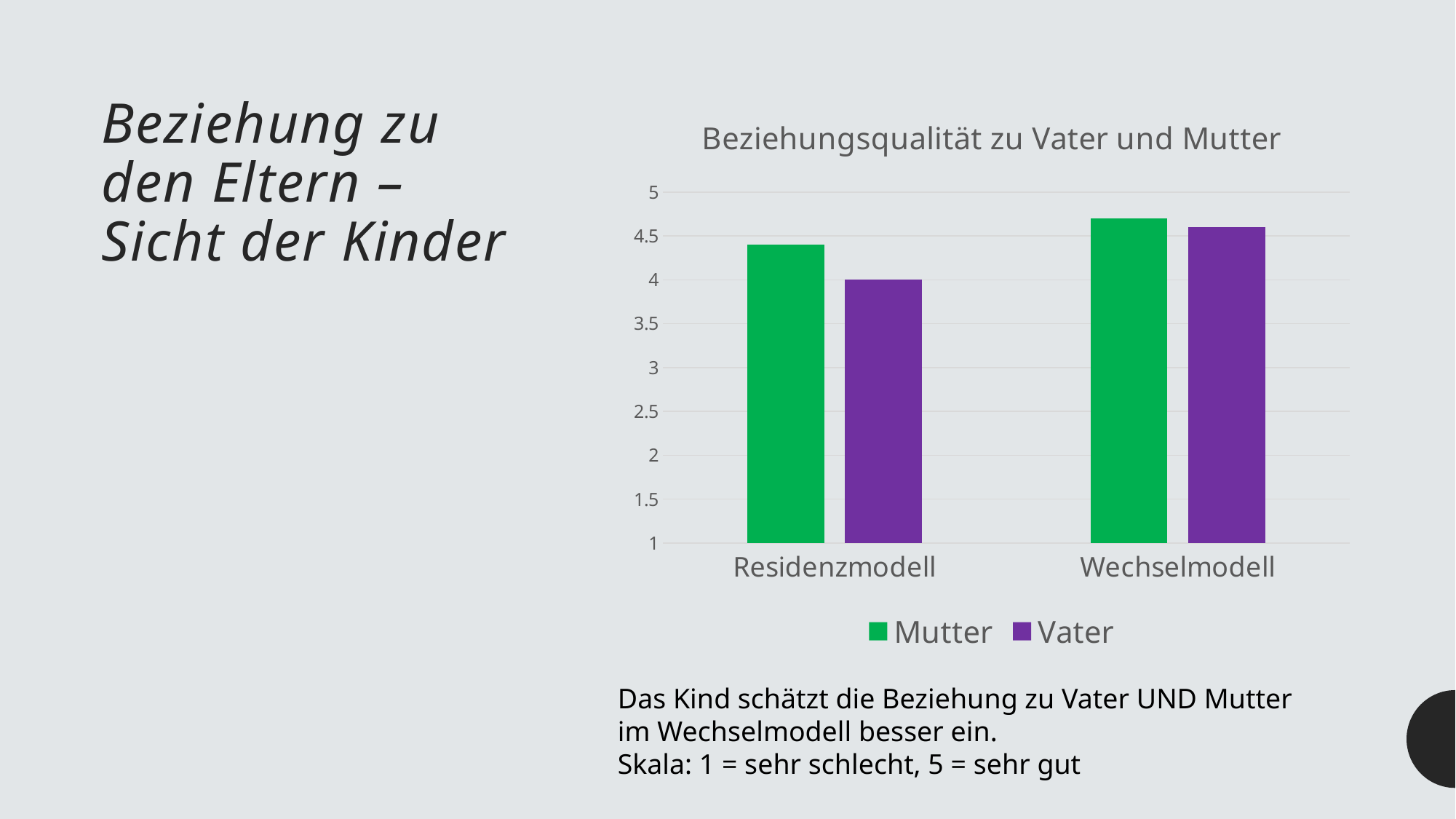
Is the value for Mutter in the Residenzmodell category greater or less than 4? greater Which bar is the lowest in the chart? Vater, Residenzmodell How many categories are shown on the x axis? 2 Is the value for Mutter in the Wechselmodell category greater or less than 4.5? greater Is the value for Vater in the Wechselmodell category greater or less than 4? greater Do the values for Vater rise or fall from Residenzmodell to Wechselmodell? rise What is the value for Vater in the Residenzmodell category? 4 What kind of chart is shown on the slide? bar chart What is the title of the chart? Beziehungsqualität zu Vater und Mutter How many series does the legend list? 2 Which colour represents the Mutter series? green In the Residenzmodell category, which is larger: Mutter or Vater? Mutter